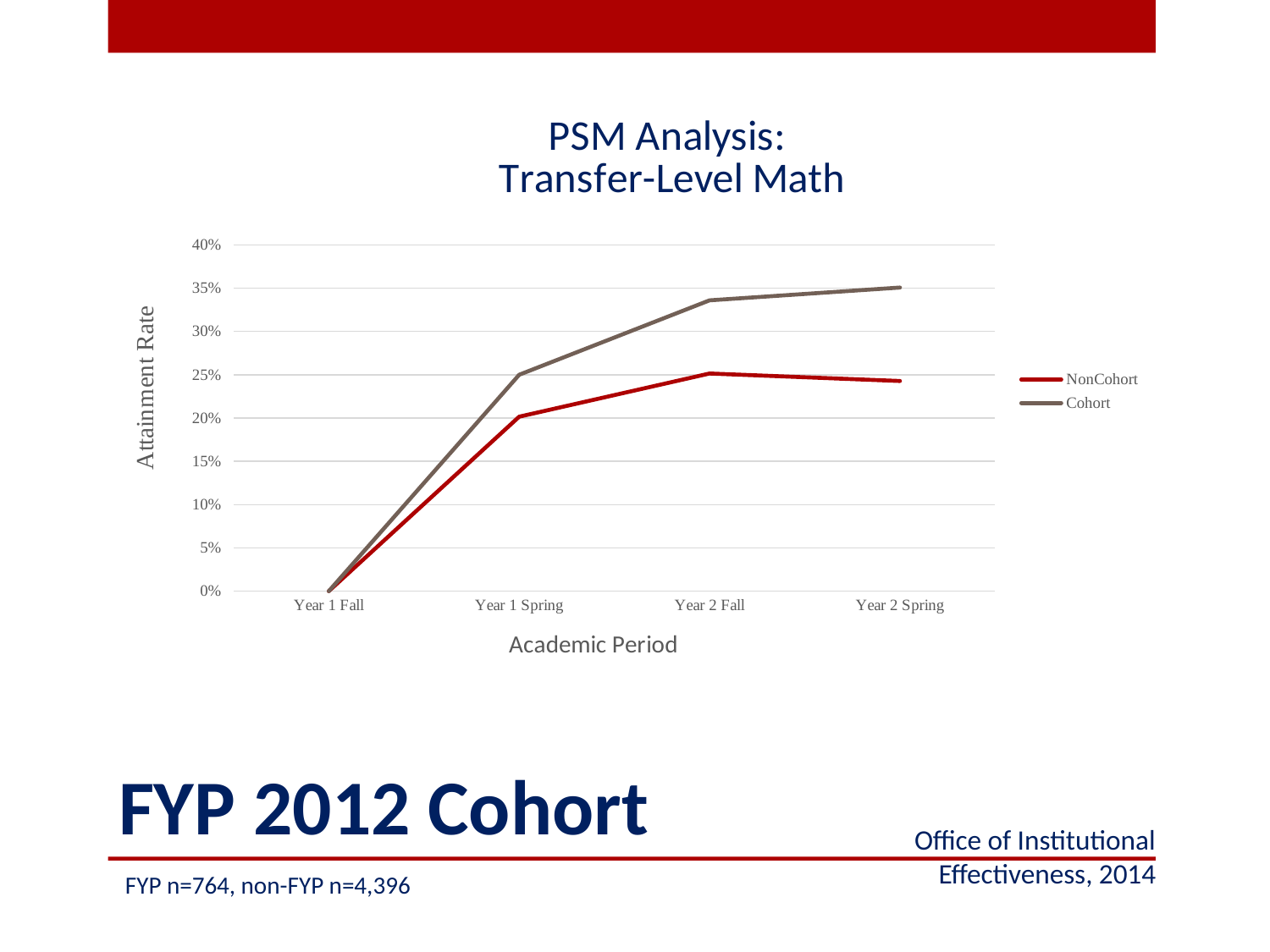
At which academic period is the Cohort attainment rate highest? Year 2 Spring How many academic periods are plotted along the x axis? 4 What is the Cohort attainment rate at Year 1 Fall? 0% Is the Cohort value at Year 2 Fall greater or less than 30%? greater What kind of chart is shown on the slide? line chart How many series does the legend list? 2 What is the label of the y axis? Attainment Rate Which series has the higher value at Year 1 Spring, Cohort or NonCohort? Cohort What is the title of the chart? PSM Analysis: Transfer-Level Math Is the NonCohort value at Year 2 Fall greater or less than 20%? greater Does the Cohort line rise or fall from Year 1 Fall to Year 2 Spring? rise Which series has the higher value at Year 2 Spring, Cohort or NonCohort? Cohort